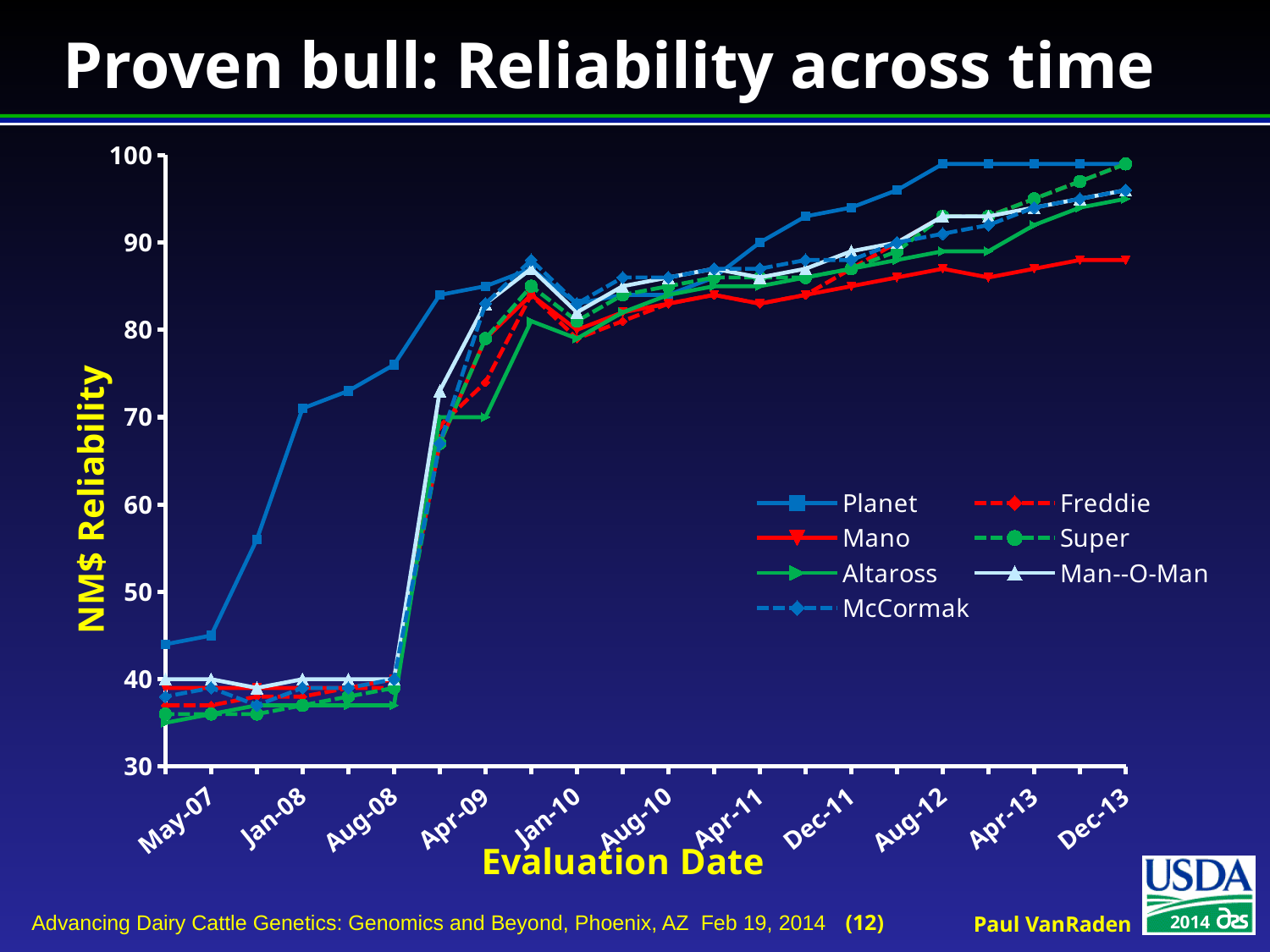
What kind of chart is shown on the slide? line chart What is the label of the y axis? NM$ Reliability What is the title of the chart on the slide? Proven bull: Reliability across time Does the NM$ Reliability for Planet generally rise or fall from May-07 to Dec-13? rise Is the value for Mano at May-07 greater or less than 50? less Which series has the lowest NM$ Reliability at Dec-13? Mano How many series does the legend list? 7 Is the value for Planet at Aug-12 greater or less than 90? greater At Dec-13, which series has the larger value, Planet or Mano? Planet How many dates are labelled on the x axis? 11 Is the value for Planet at May-07 greater or less than 50? less